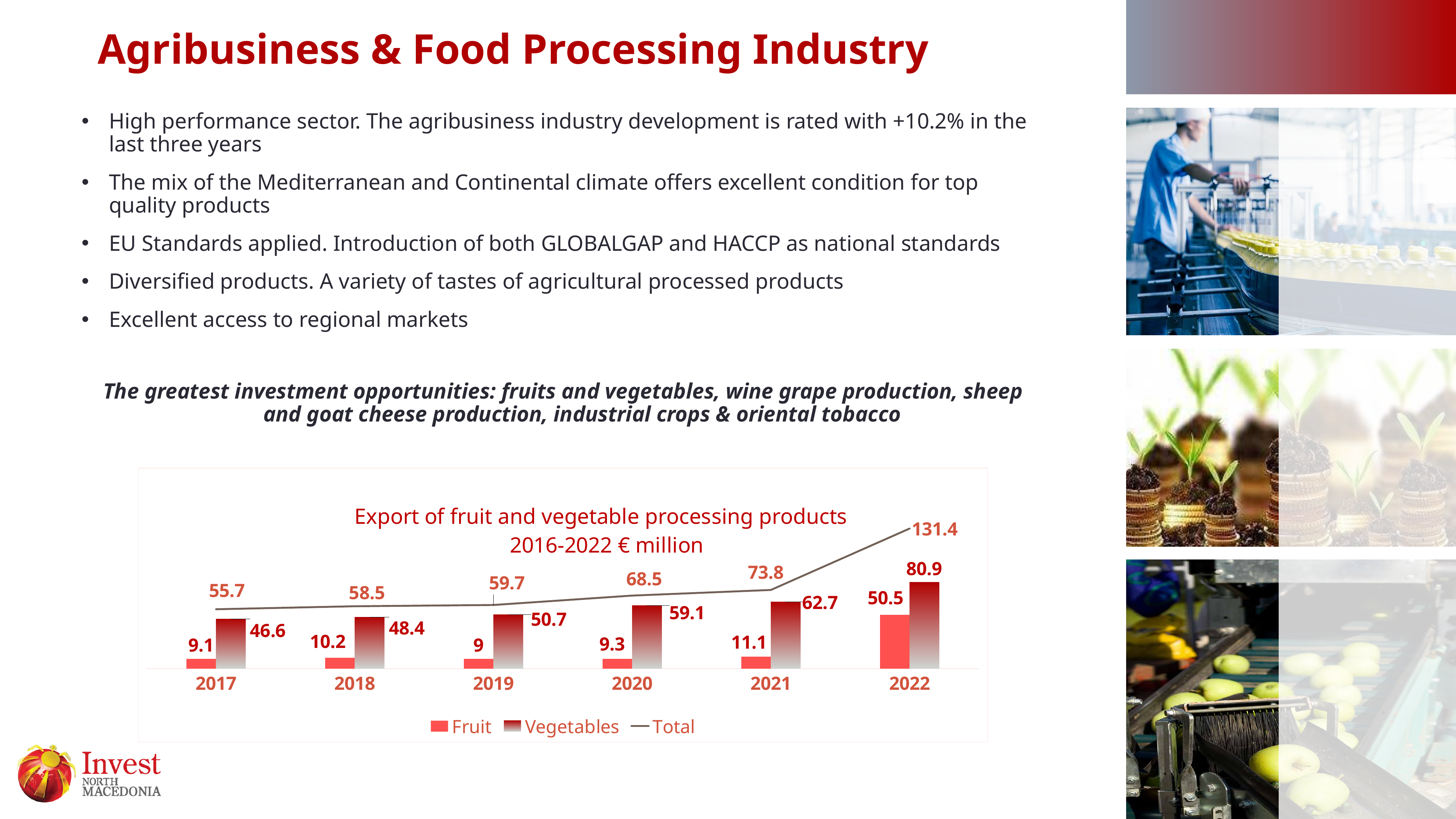
What is the Vegetables export value for 2019? 50.7 Which year has the highest Total export value? 2022 What is the difference between the Vegetables values for 2022 and 2021? 18.2 What kind of chart is shown on the slide? Combined bar and line chart How many series does the legend list? 3 How many years are shown on the x axis? 6 Does the Total line rise or fall from 2017 to 2022? Rise Which is larger, the Fruit value for 2018 or the Fruit value for 2021? 2021 Which year has the lowest Fruit export value? 2019 What is the Fruit export value for 2022? 50.5 What is the Total export value for 2020? 68.5 What is the title of the chart? Export of fruit and vegetable processing products 2016-2022 € million